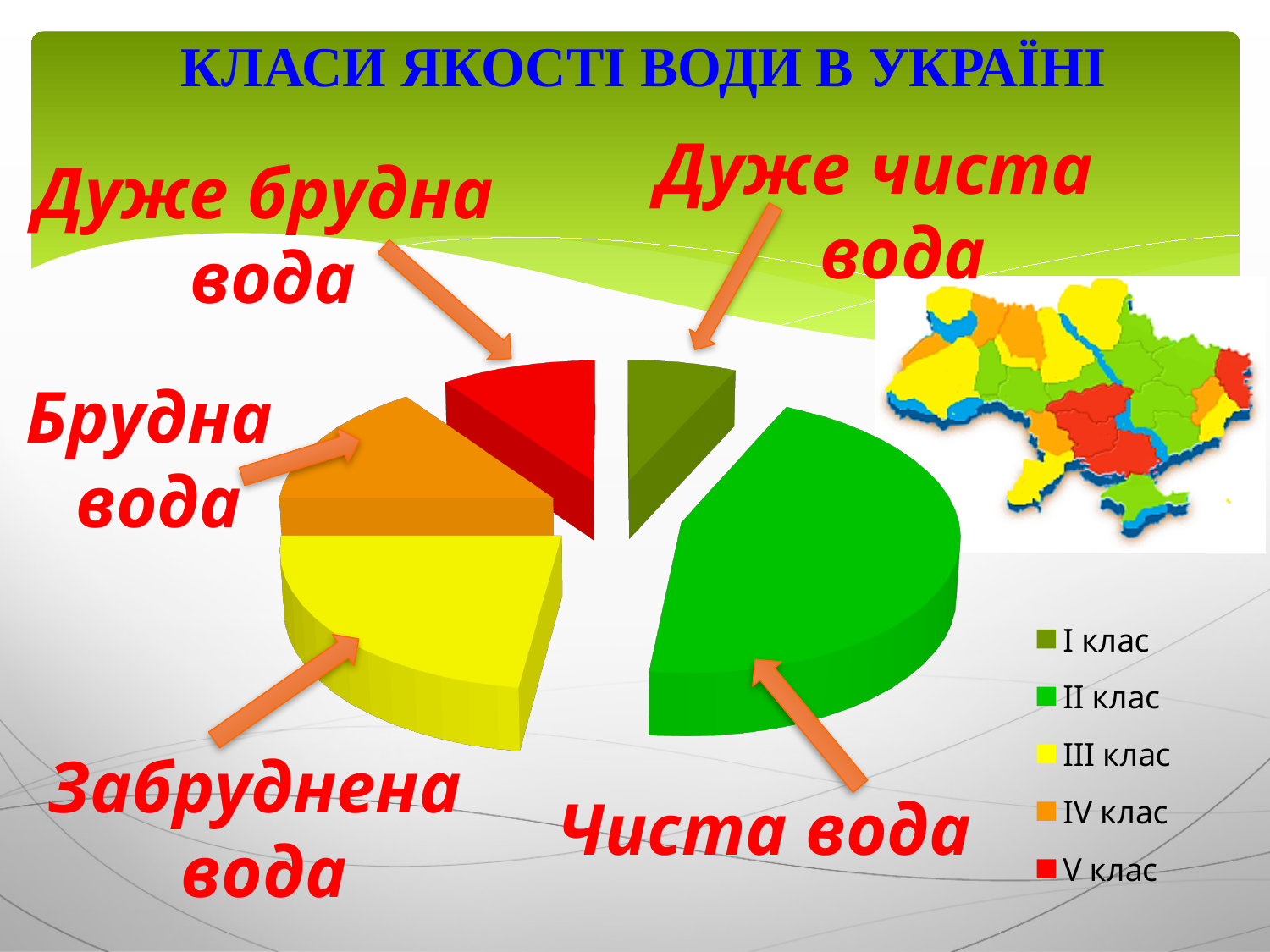
Which slice is larger, IV клас or I клас? IV клас Which slice is larger, III клас or V клас? III клас How many slices does the pie chart have? 5 What kind of chart is shown on the slide? pie chart Which slice is larger, II клас or III клас? II клас What is the title of the slide with the pie chart? КЛАСИ ЯКОСТІ ВОДИ В УКРАЇНІ How many entries does the legend of the pie chart list? 5 What colour is the slice for III клас in the pie chart? yellow Which class has the smallest slice in the pie chart? I клас Which class has the largest slice in the pie chart? II клас